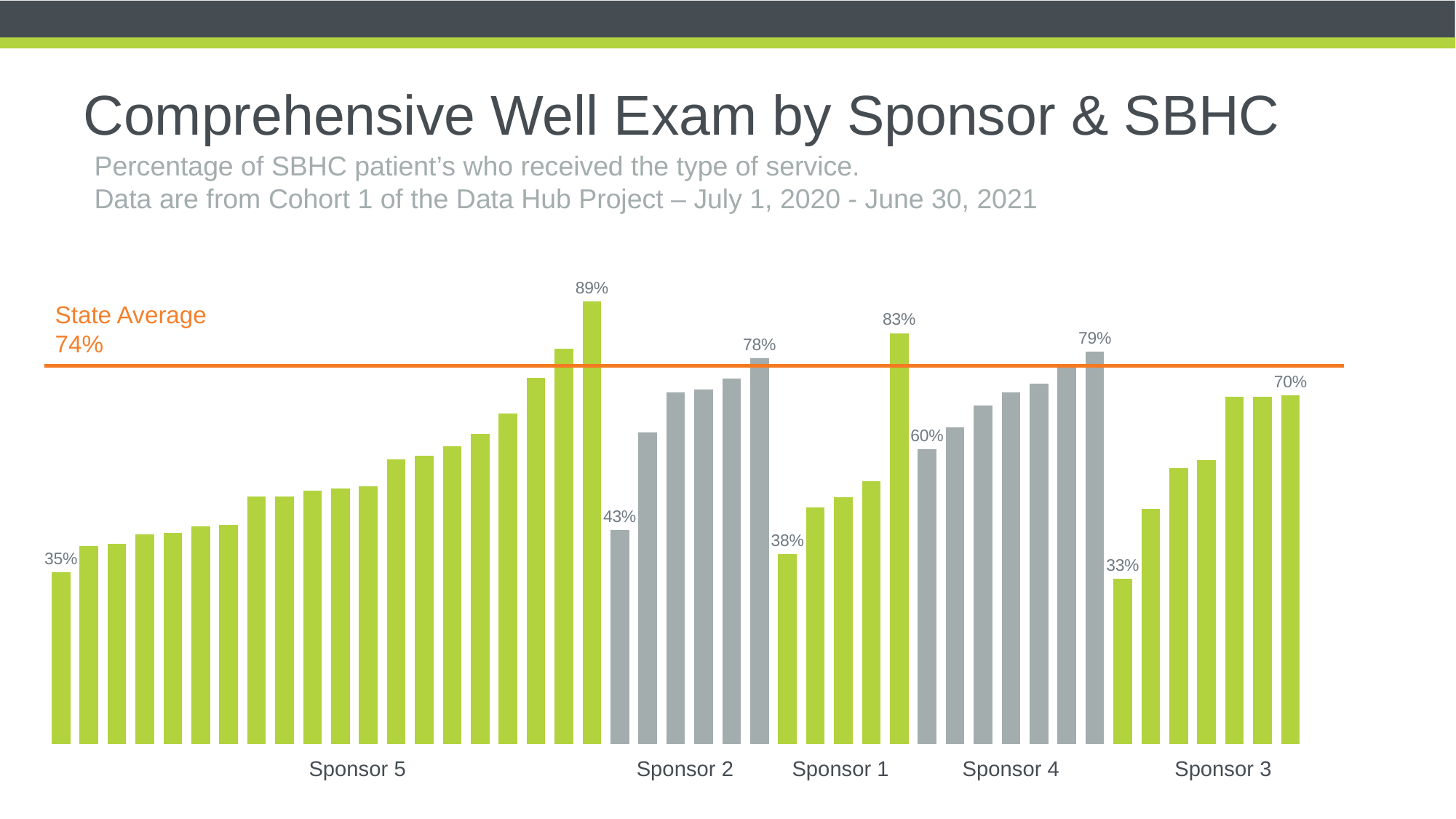
What is the highest value shown for Sponsor 2? 78% What is the difference between the highest and lowest values for Sponsor 5? 54 percentage points Which sponsor group contains the single highest SBHC value on the chart? Sponsor 5 What is the highest value shown for Sponsor 3? 70% What is the lowest value shown for Sponsor 3? 33% Which is larger, the highest value for Sponsor 1 or the highest value for Sponsor 4? Sponsor 1 What is the lowest value shown for Sponsor 5? 35% What is the lowest value shown for Sponsor 1? 38% How many sponsor groups are shown on the x axis? 5 What is the State Average shown on the chart? 74%